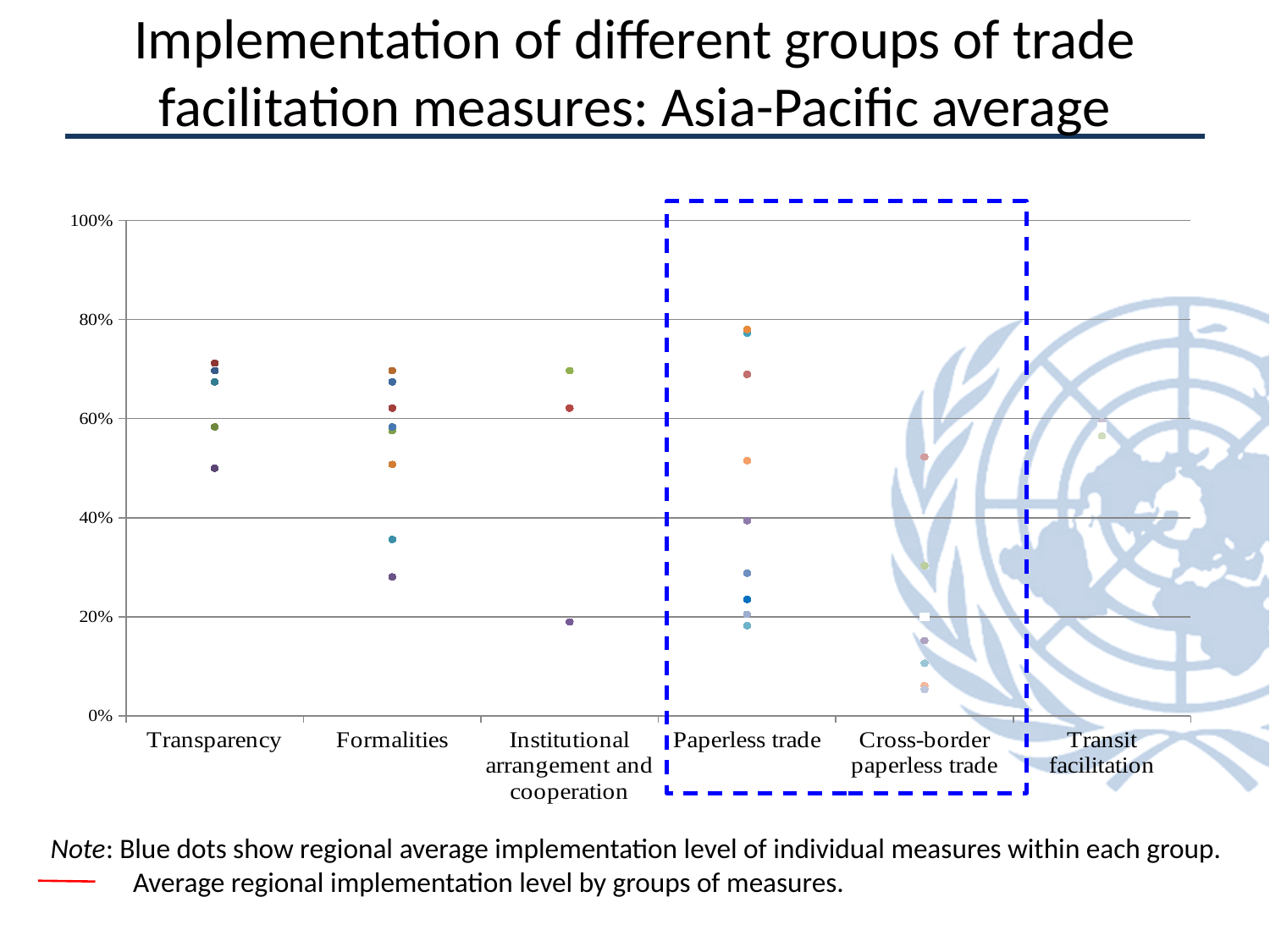
Which group of measures contains the highest plotted dot? Paperless trade Is the lowest dot for Cross-border paperless trade greater or less than 20%? less Which two groups of measures are enclosed by the dashed blue box? Paperless trade and Cross-border paperless trade What is the title of the slide containing the chart? Implementation of different groups of trade facilitation measures: Asia-Pacific average Is the lowest dot for Formalities greater or less than 20%? greater Is the highest dot for Paperless trade greater or less than 60%? greater Which group of measures contains the lowest plotted dot? Cross-border paperless trade What kind of chart is shown on the slide? scatter chart How many groups of measures are shown along the x axis? 6